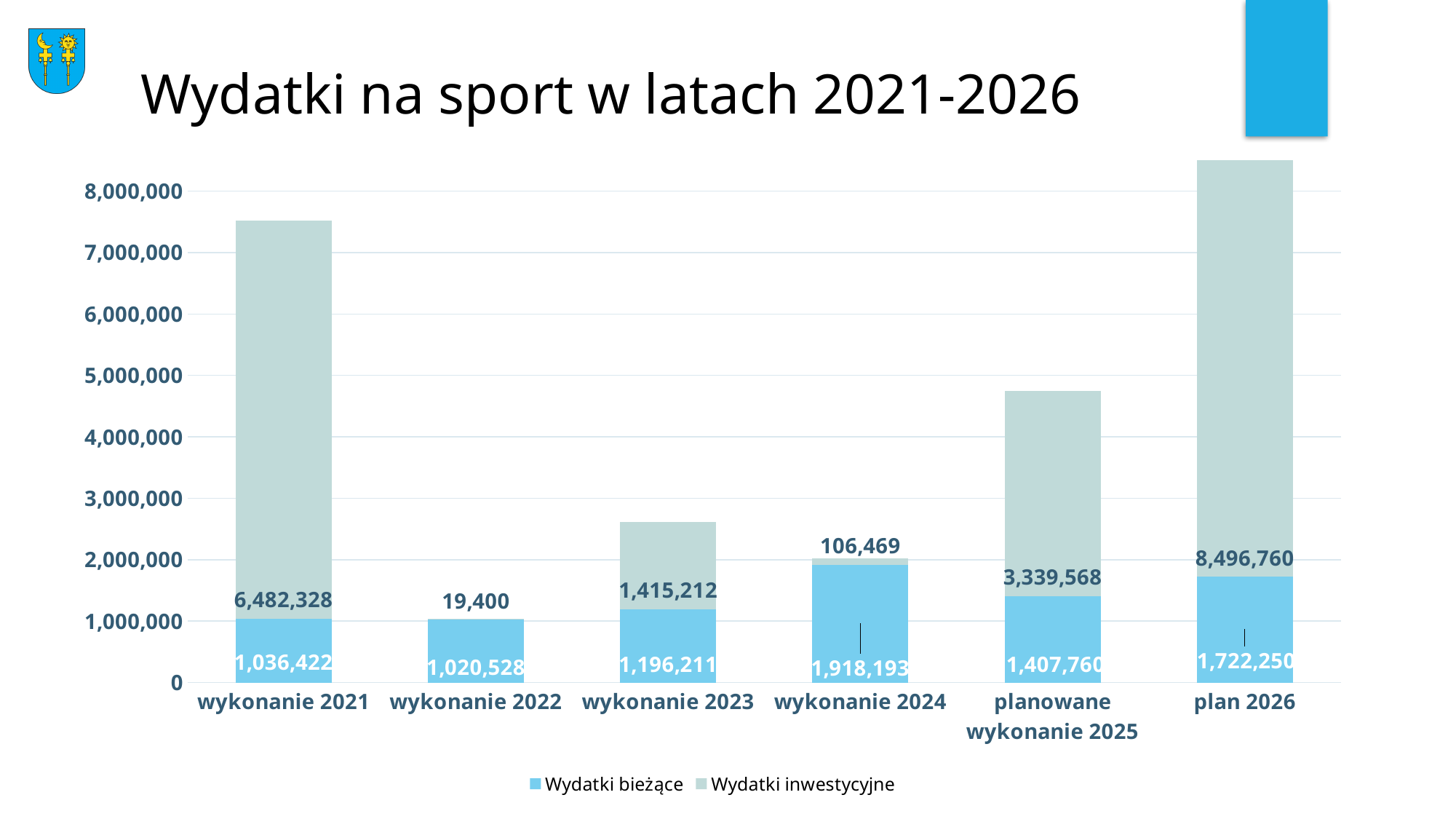
What is the value of Wydatki inwestycyjne for wykonanie 2021? 6,482,328 How many series does the legend list? 2 Which category has the lowest value of Wydatki inwestycyjne? wykonanie 2022 Which is larger: Wydatki bieżące for wykonanie 2024 or for wykonanie 2023? wykonanie 2024 What is the value of Wydatki inwestycyjne for wykonanie 2022? 19,400 What is the difference between Wydatki bieżące for wykonanie 2023 and wykonanie 2022? 175,683 What kind of chart is shown on the slide? Stacked bar chart How many categories are shown on the x axis? 6 What is the total of the stacked bar for wykonanie 2021? 7,518,750 What is the value of Wydatki bieżące for wykonanie 2024? 1,918,193 Which category has the tallest stacked bar overall? plan 2026 Is the total of the stacked bar for planowane wykonanie 2025 greater or less than 4,000,000? greater